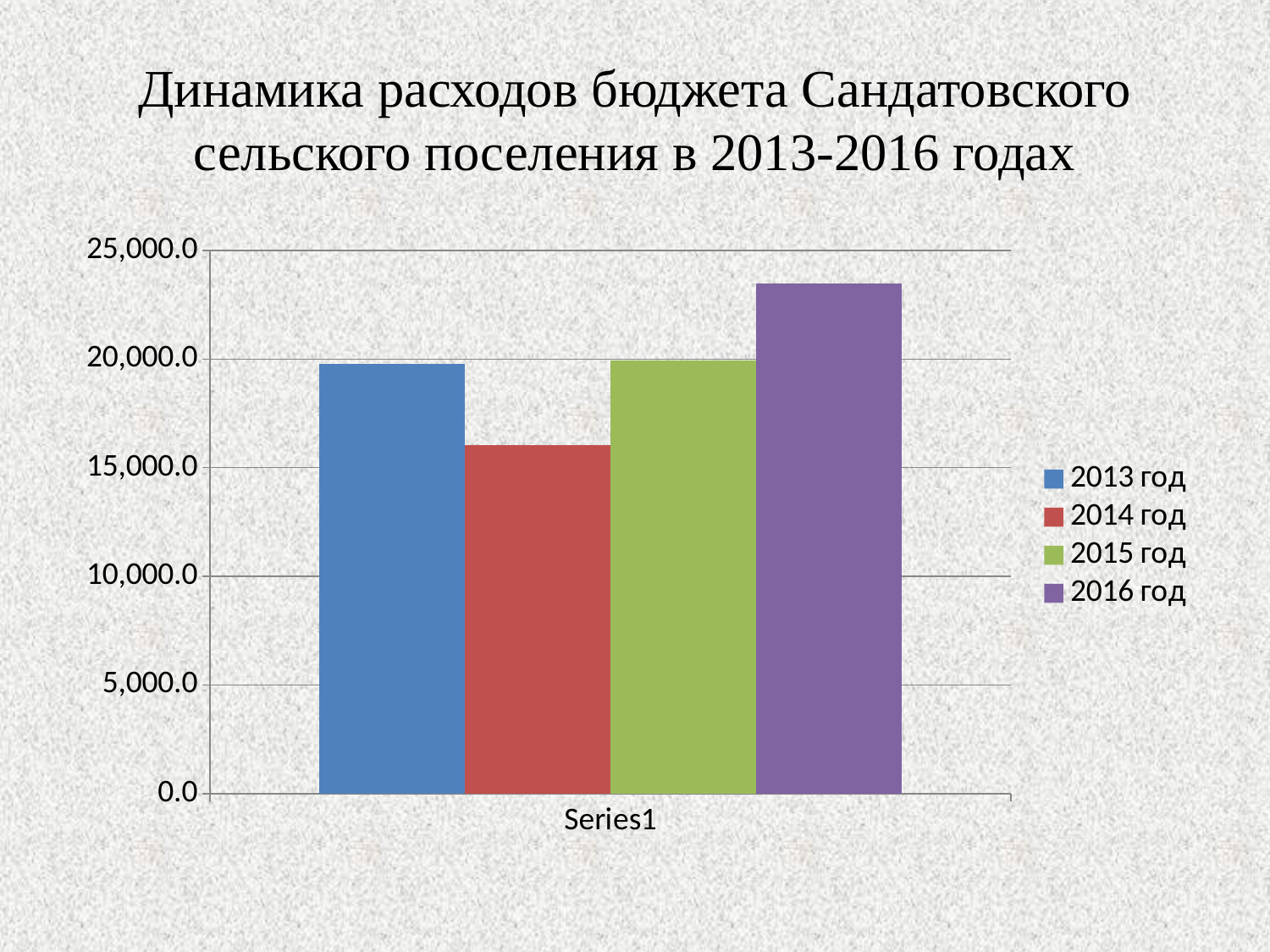
Which is larger, the value for 2016 год or the value for 2015 год? 2016 год Is the value for 2016 год greater or less than 20,000.0? greater How many series does the legend list? 4 Is the value for 2016 год greater or less than 25,000.0? less What kind of chart is shown on the slide? bar chart Is the value for 2014 год greater or less than 15,000.0? greater Which year has the highest bar? 2016 год What colour is the bar for 2016 год? purple Which year has the lowest bar? 2014 год What is the title of the slide? Динамика расходов бюджета Сандатовского сельского поселения в 2013-2016 годах Which is larger, the value for 2013 год or the value for 2014 год? 2013 год